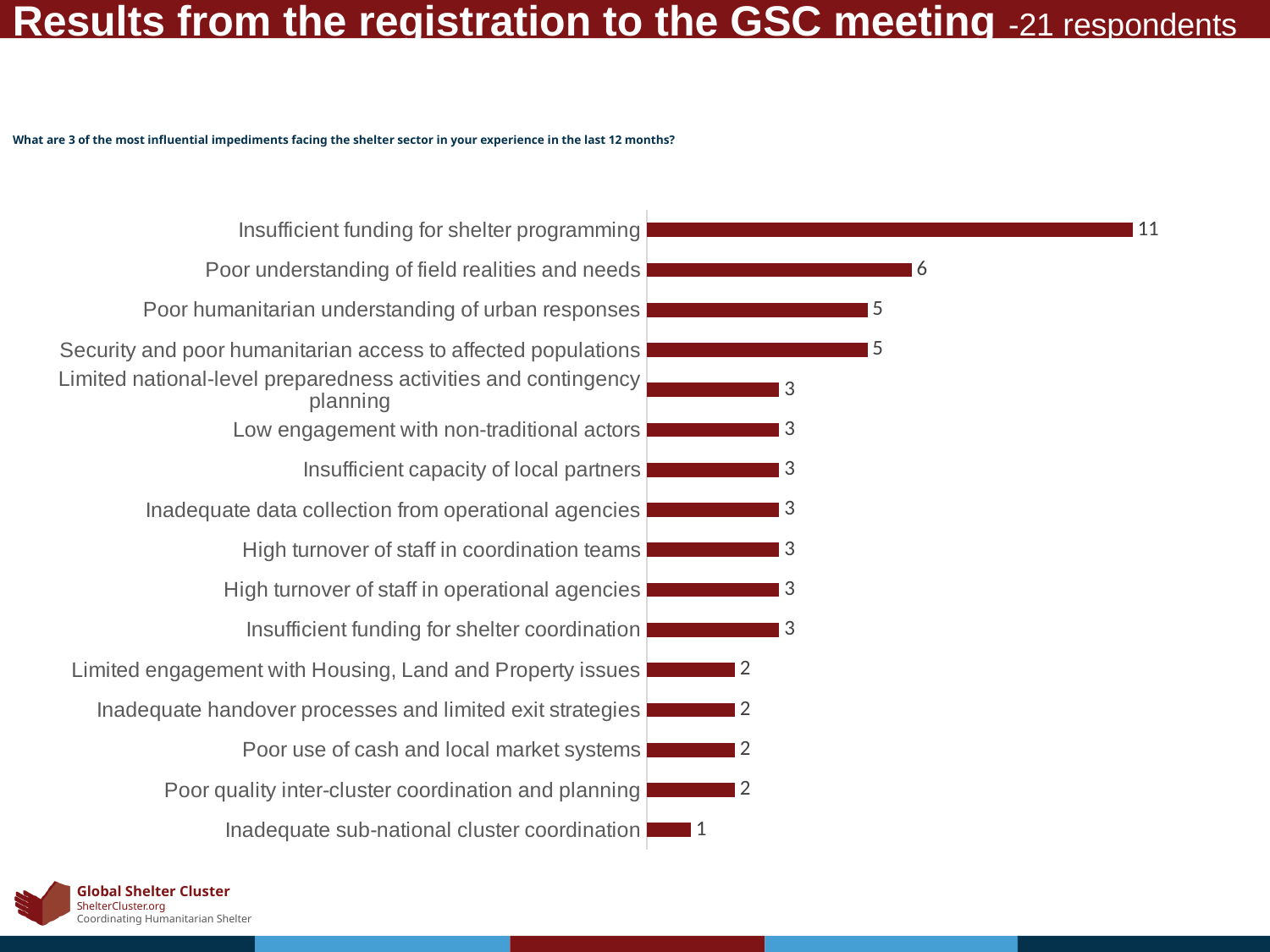
Which has a larger value: "Limited engagement with Housing, Land and Property issues" or "Insufficient funding for shelter coordination"? Insufficient funding for shelter coordination Which category has the lowest value? Inadequate sub-national cluster coordination What value is shown for "Poor understanding of field realities and needs"? 6 What is the difference between the values for "Insufficient funding for shelter programming" and "Poor understanding of field realities and needs"? 5 Which has a larger value: "Security and poor humanitarian access to affected populations" or "Low engagement with non-traditional actors"? Security and poor humanitarian access to affected populations What value is shown for "High turnover of staff in coordination teams"? 3 Which category has the highest value? Insufficient funding for shelter programming What value is shown for "Poor use of cash and local market systems"? 2 What kind of chart is shown on the slide? Bar chart What is the difference between the values for "Poor humanitarian understanding of urban responses" and "Inadequate sub-national cluster coordination"? 4 How many categories are shown in the chart? 16 What value is shown for "Insufficient funding for shelter programming"? 11